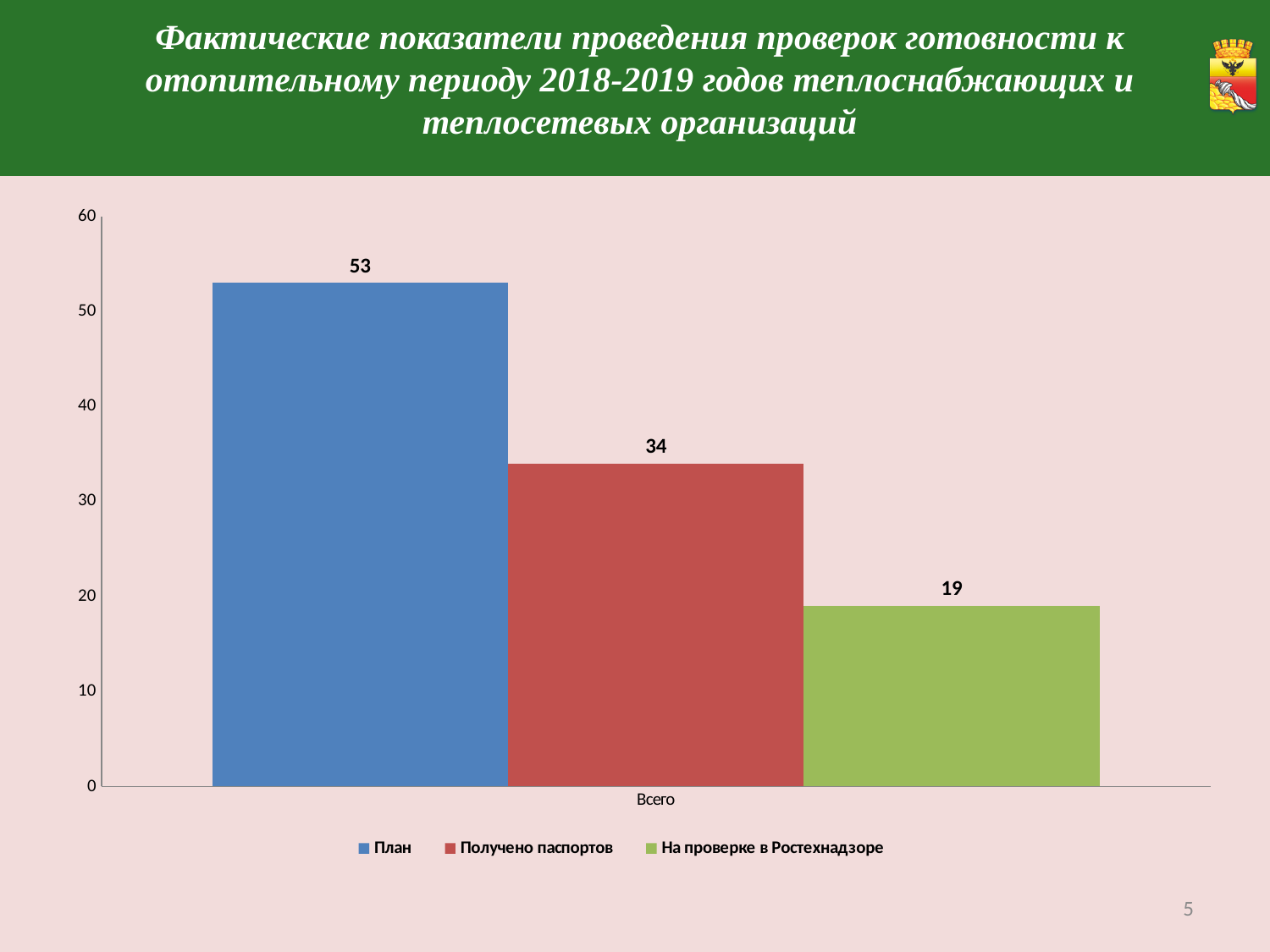
What is the difference between the План value and the Получено паспортов value? 19 What is the value of the На проверке в Ростехнадзоре series? 19 How many series does the legend list? 3 What is the value of the План series? 53 Which series has the lowest value? На проверке в Ростехнадзоре What is the value of the Получено паспортов series? 34 What kind of chart is shown on the slide? bar chart Is the value for План greater or less than 50? greater What is the difference between the Получено паспортов value and the На проверке в Ростехнадзоре value? 15 Which is larger, the value for Получено паспортов or the value for На проверке в Ростехнадзоре? Получено паспортов What is the label on the x axis under the bars? Всего Which series has the highest value? План